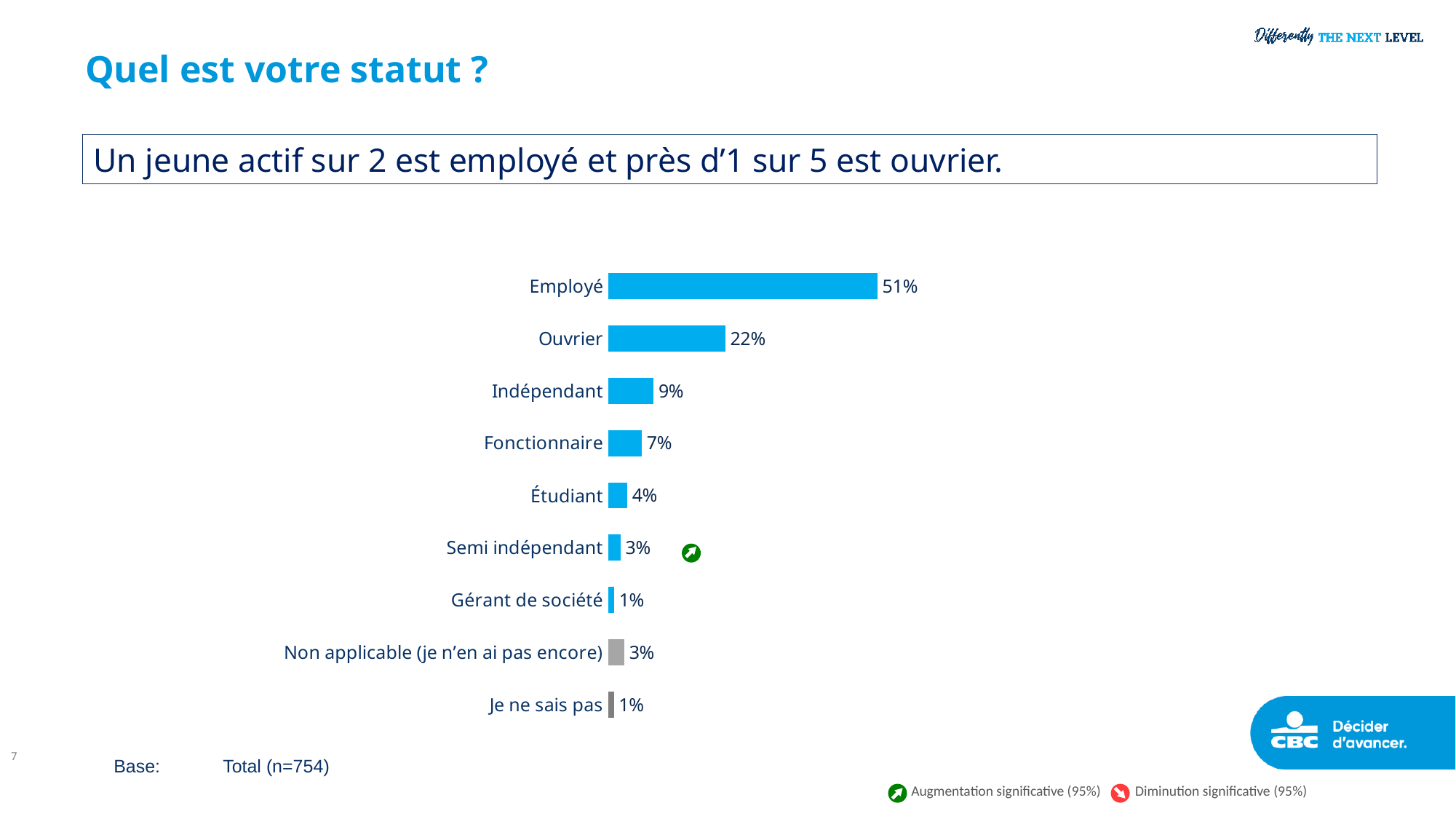
What is the base (sample size) stated for the chart? Total (n=754) What is the value for Employé? 51% Which category has the highest value? Employé What is the value for Fonctionnaire? 7% What is the value for Ouvrier? 22% What is the difference between the values for Indépendant and Fonctionnaire? 2% Which category is marked with a green arrow indicating a significant increase? Semi indépendant Which is larger, the value for Indépendant or the value for Étudiant? Indépendant What is the difference between the values for Employé and Ouvrier? 29% What kind of chart is shown on the slide? Bar chart How many categories are shown in the chart? 9 What is the value for Non applicable (je n'en ai pas encore)? 3%